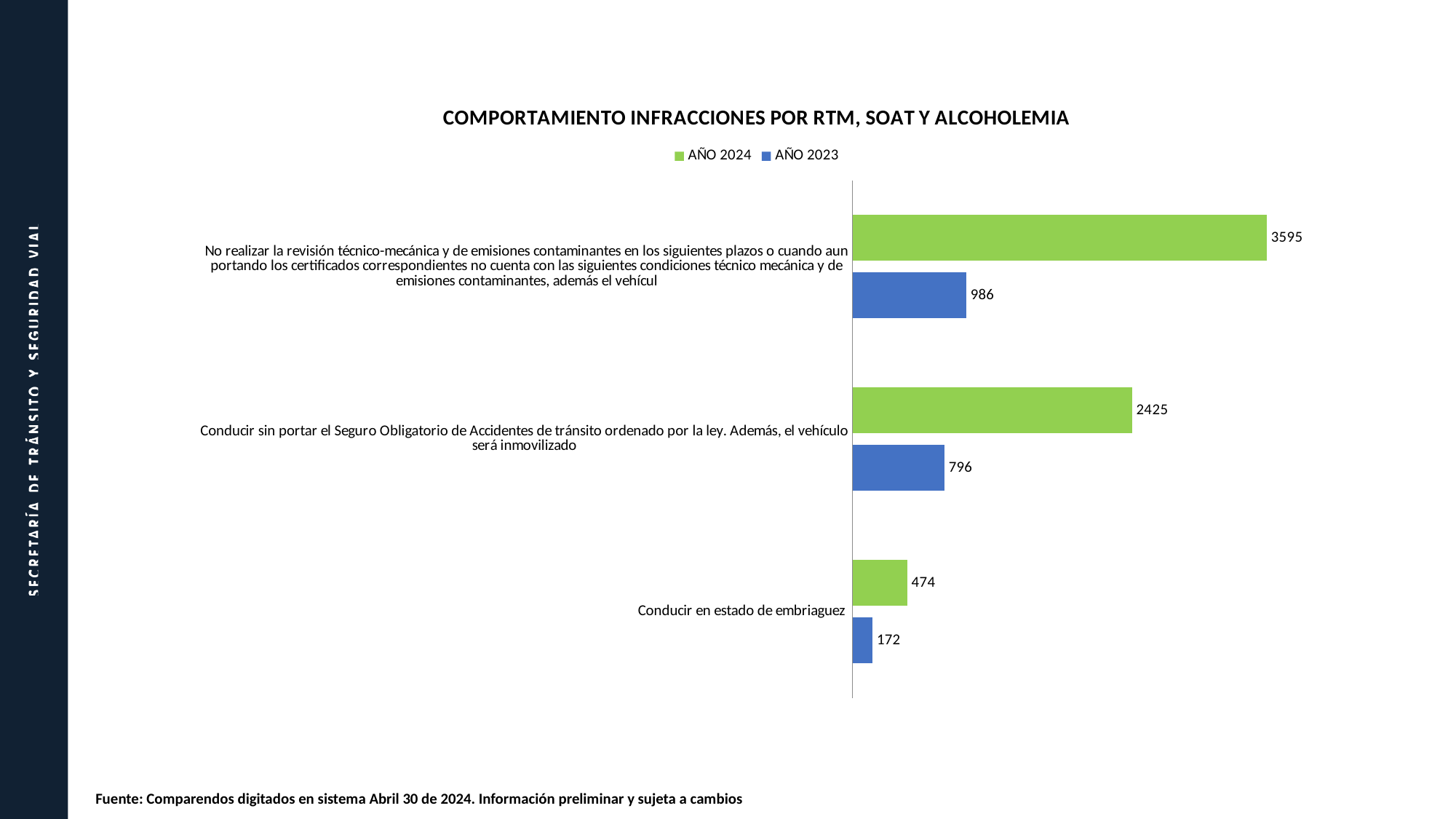
What is the AÑO 2024 value for the category about not performing the revisión técnico-mecánica? 3595 How many series does the legend list? 2 What is the AÑO 2024 value for 'Conducir en estado de embriaguez'? 474 What is the AÑO 2023 value for 'Conducir en estado de embriaguez'? 172 What is the difference between the AÑO 2024 and AÑO 2023 values for 'Conducir en estado de embriaguez'? 302 What is the AÑO 2023 value for 'Conducir sin portar el Seguro Obligatorio de Accidentes de tránsito ordenado por la ley. Además, el vehículo será inmovilizado'? 796 What is the difference between the AÑO 2024 and AÑO 2023 values for the SOAT category (Conducir sin portar el Seguro Obligatorio)? 1629 Which is larger for the revisión técnico-mecánica category: the AÑO 2024 value or the AÑO 2023 value? AÑO 2024 Which category has the highest AÑO 2024 value? No realizar la revisión técnico-mecánica y de emisiones contaminantes... How many categories are shown on the chart? 3 What type of chart is shown on the slide? Bar chart Which category has the lowest AÑO 2023 value? Conducir en estado de embriaguez